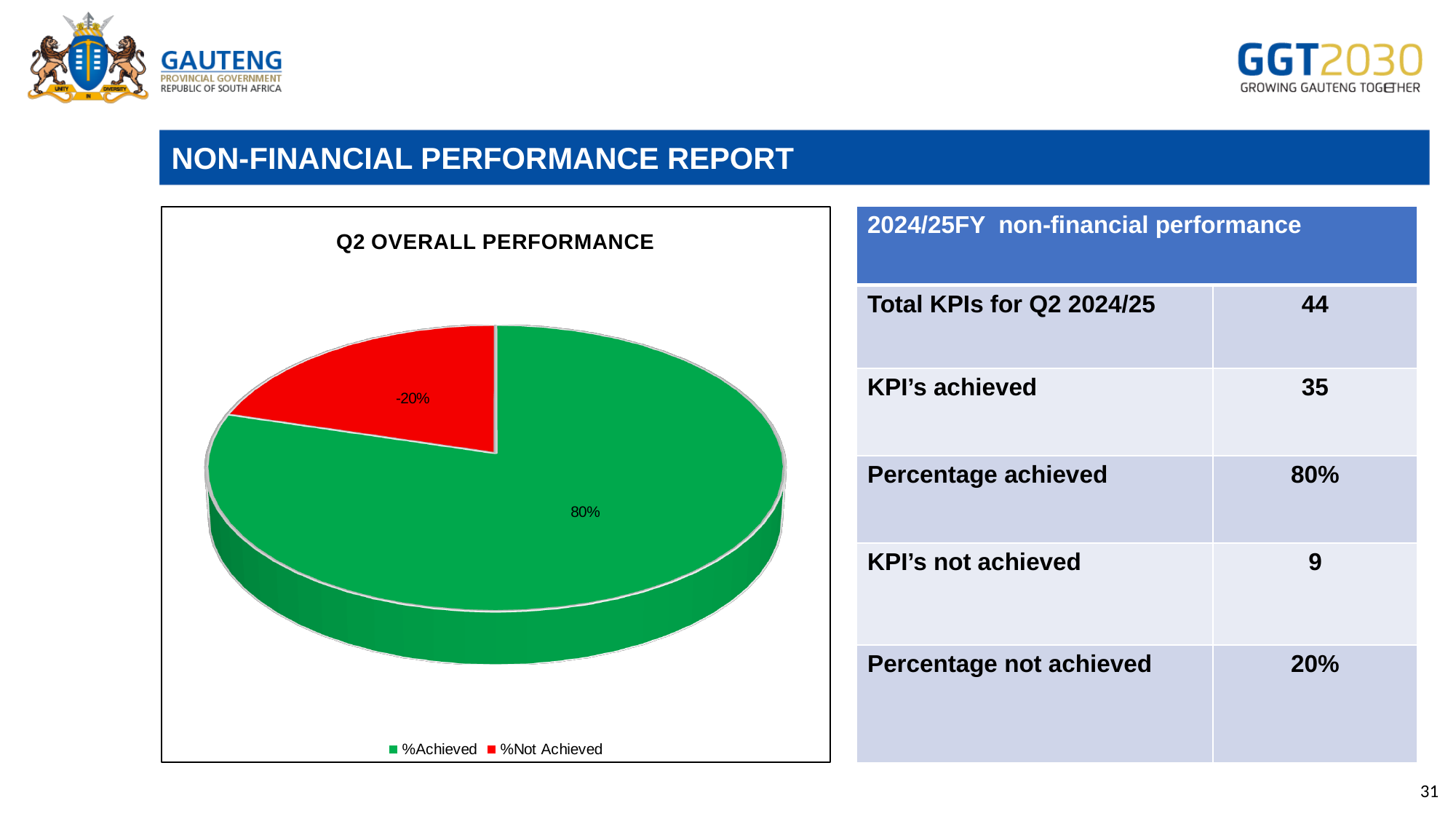
Which is larger, the %Achieved slice or the %Not Achieved slice? %Achieved What type of chart is shown on the slide? pie chart How many entries does the chart legend list? 2 What data label is shown on the %Not Achieved slice? -20% Which slice is the largest in the pie chart? %Achieved How many slices does the pie chart have? 2 What colour is the %Not Achieved slice in the pie chart? red Is the share for %Achieved greater or less than 50%? greater What is the title of the chart? Q2 OVERALL PERFORMANCE What share of the pie is labelled for %Achieved? 80% Which slice is the smallest in the pie chart? %Not Achieved